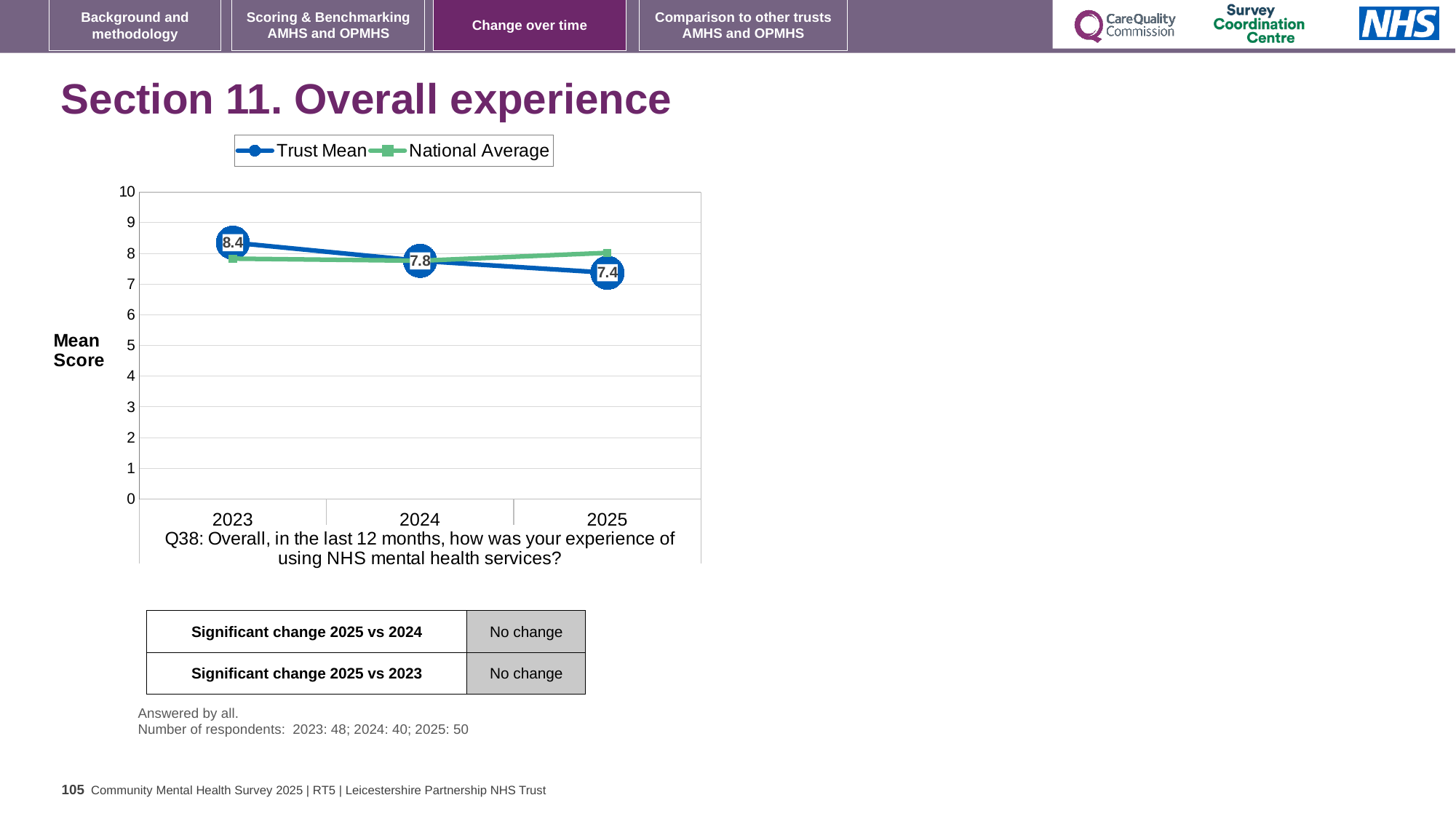
How many years are shown on the x axis of the chart? 3 How many series does the chart legend list? 2 What is the Trust Mean score for 2025? 7.4 In 2025, which is higher: the Trust Mean or the National Average? National Average In which year is the Trust Mean score lowest? 2025 Is the National Average value for 2025 greater or less than 7? greater What is the difference between the Trust Mean score in 2023 and in 2025? 1.0 What is the Trust Mean score for 2023? 8.4 In 2023, which is higher: the Trust Mean or the National Average? Trust Mean In which year is the Trust Mean score highest? 2023 What is the Trust Mean score for 2024? 7.8 Does the Trust Mean rise or fall from 2023 to 2025? fall